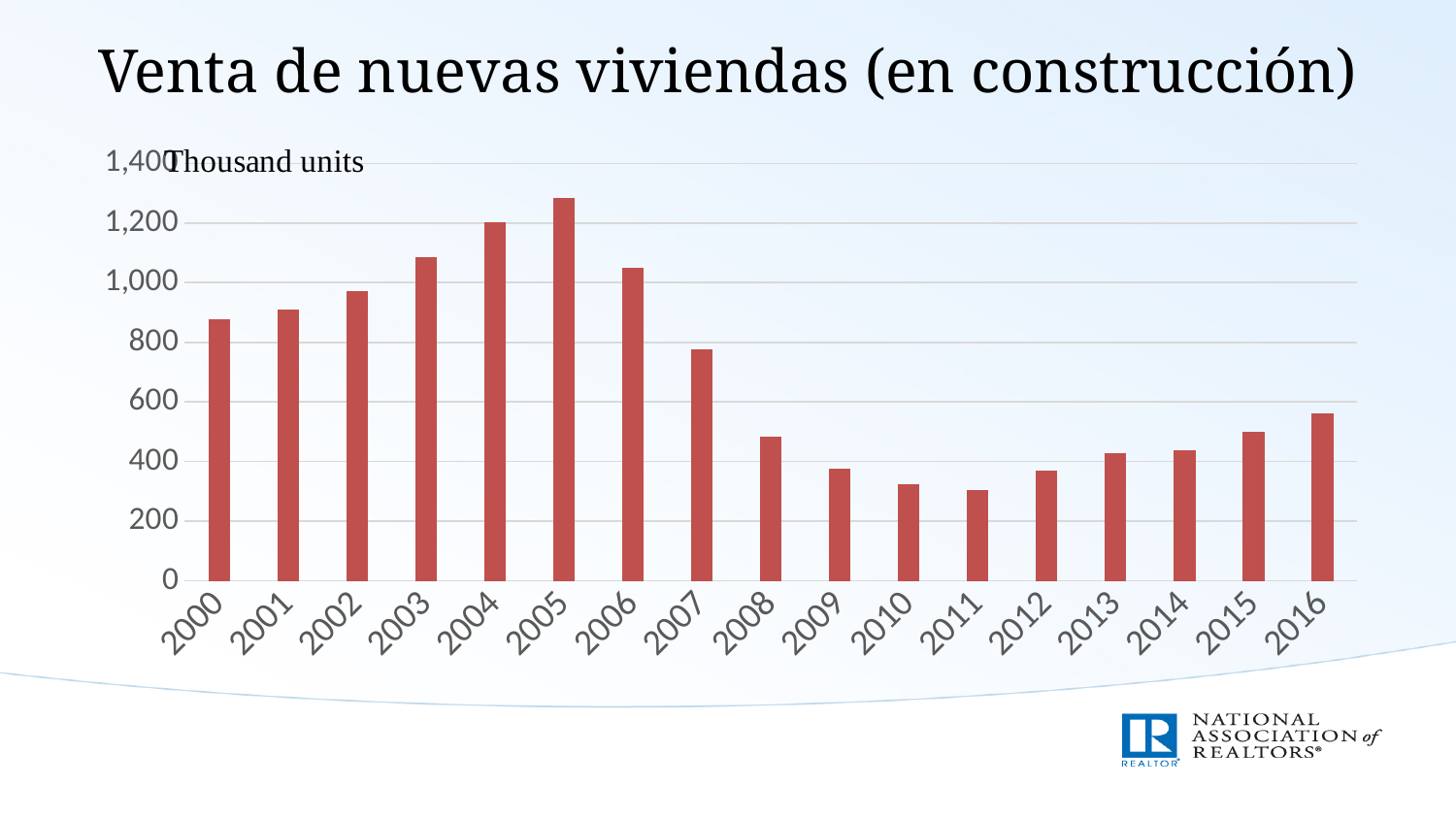
Which is larger, the value for 2004 or the value for 2008? 2004 Is the value for 2000 greater or less than 800? greater What kind of chart is shown on the slide? bar chart Is the value for 2008 greater or less than 600? less Which is larger, the value for 2012 or the value for 2016? 2016 Is the value for 2016 greater or less than 600? less What unit label is shown at the top of the y axis? Thousand units Which year has the highest value in the chart? 2005 How many years are plotted along the x axis? 17 Do the values rise or fall from 2005 to 2011? fall